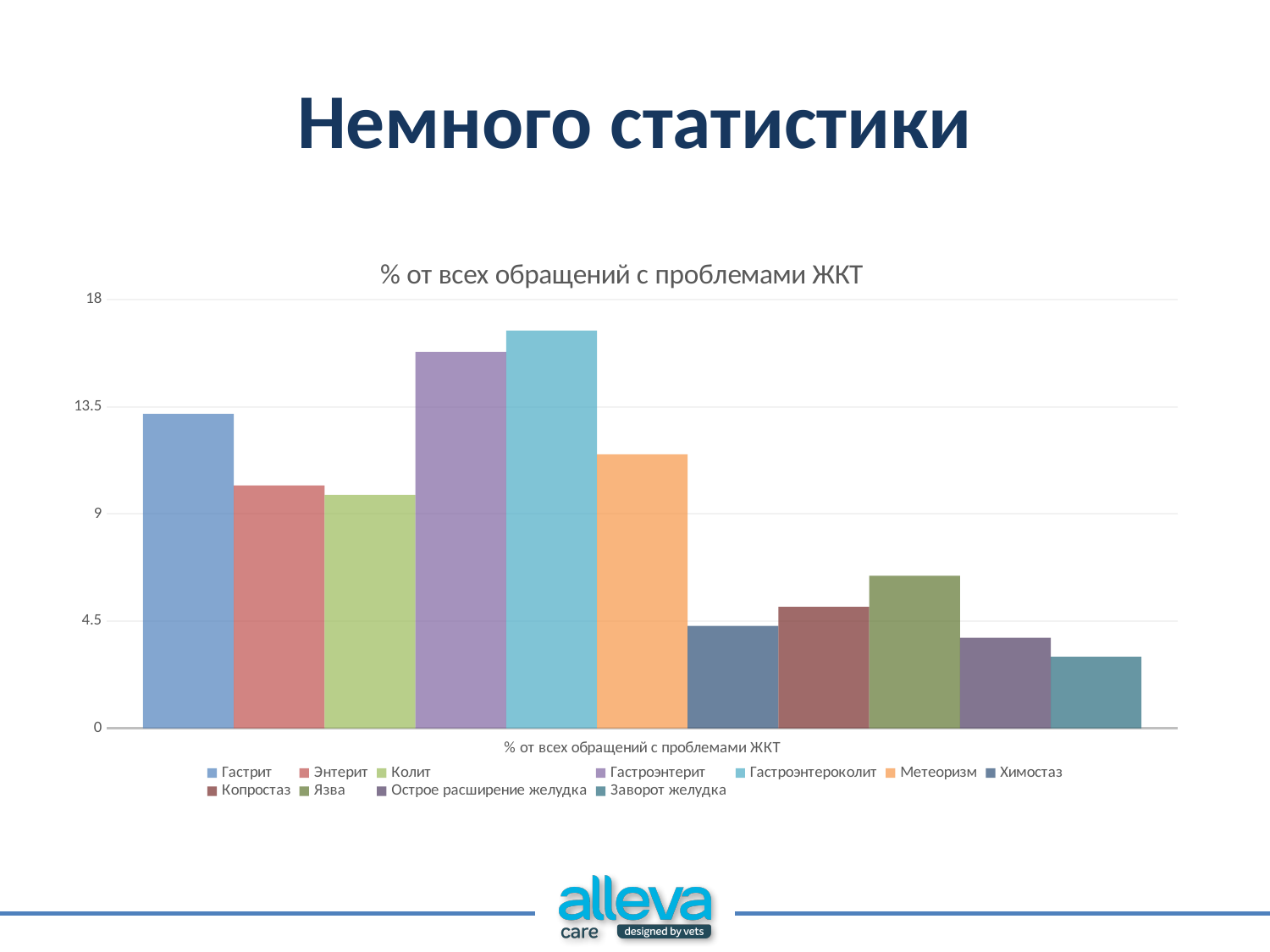
Which is larger, the value for Копростаз or the value for Язва? Язва Which series has the lowest value? Заворот желудка What is the highest value shown on the vertical axis? 18 Is the value for Язва greater or less than 9? less How many series does the legend list? 11 What is the title of the chart? % от всех обращений с проблемами ЖКТ Is the value for Гастроэнтерит greater or less than 13.5? greater Which is larger, the value for Метеоризм or the value for Энтерит? Метеоризм What kind of chart is shown on the slide? bar chart Which series has the highest value? Гастроэнтероколит Is the value for Гастрит greater or less than 9? greater